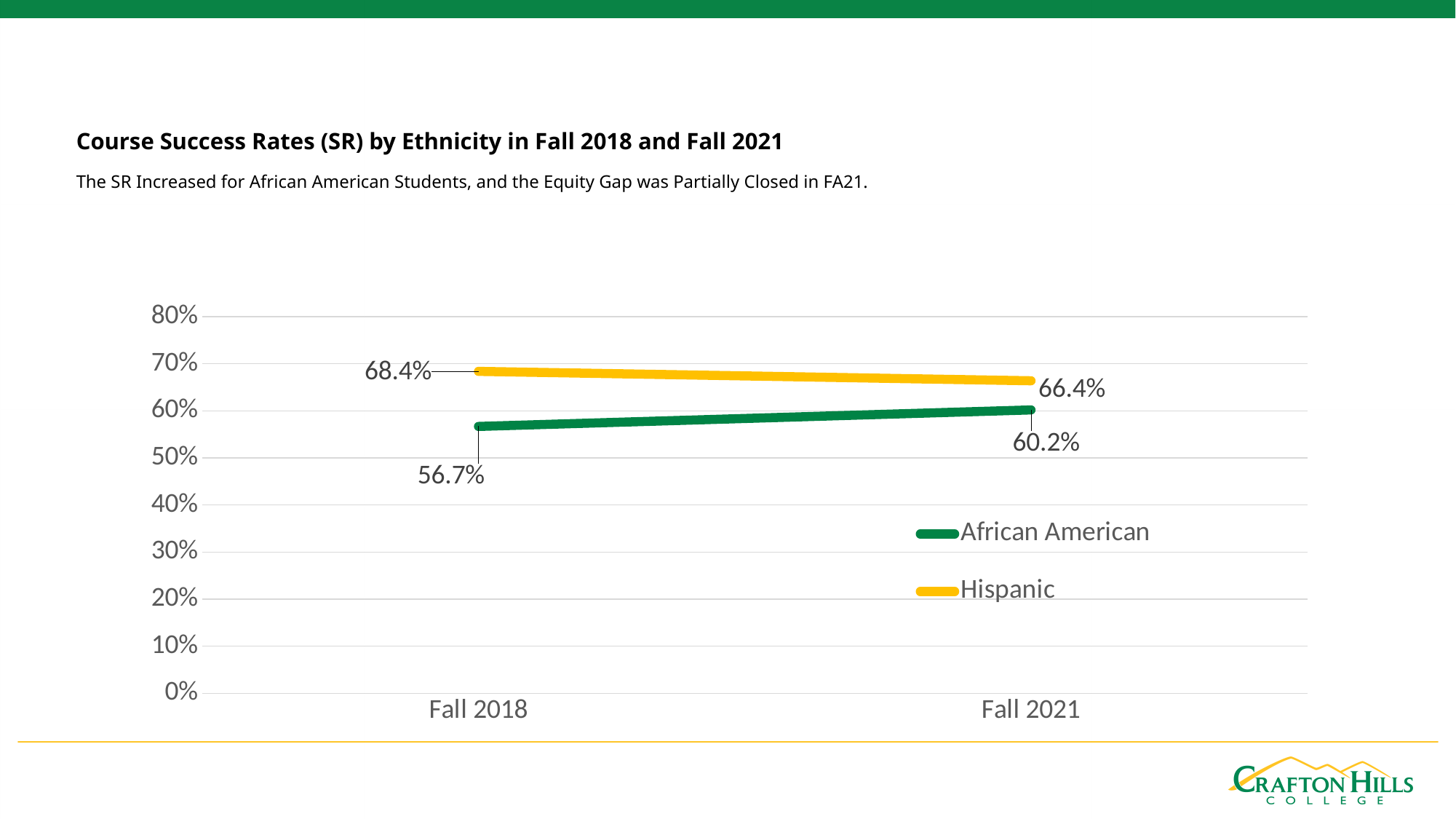
What was the course success rate for African American students in Fall 2018? 56.7% What was the course success rate for Hispanic students in Fall 2021? 66.4% What kind of chart is shown on the slide? Line chart Did the African American course success rate rise or fall from Fall 2018 to Fall 2021? Rise What was the course success rate for Hispanic students in Fall 2018? 68.4% Which series had the higher course success rate in Fall 2021? Hispanic What was the gap between the Hispanic and African American course success rates in Fall 2018? 11.7 percentage points How many series does the legend list? 2 What is the title of the chart? Course Success Rates (SR) by Ethnicity in Fall 2018 and Fall 2021 By how many percentage points did the African American course success rate change from Fall 2018 to Fall 2021? 3.5 percentage points What was the course success rate for African American students in Fall 2021? 60.2% Did the Hispanic course success rate rise or fall from Fall 2018 to Fall 2021? Fall